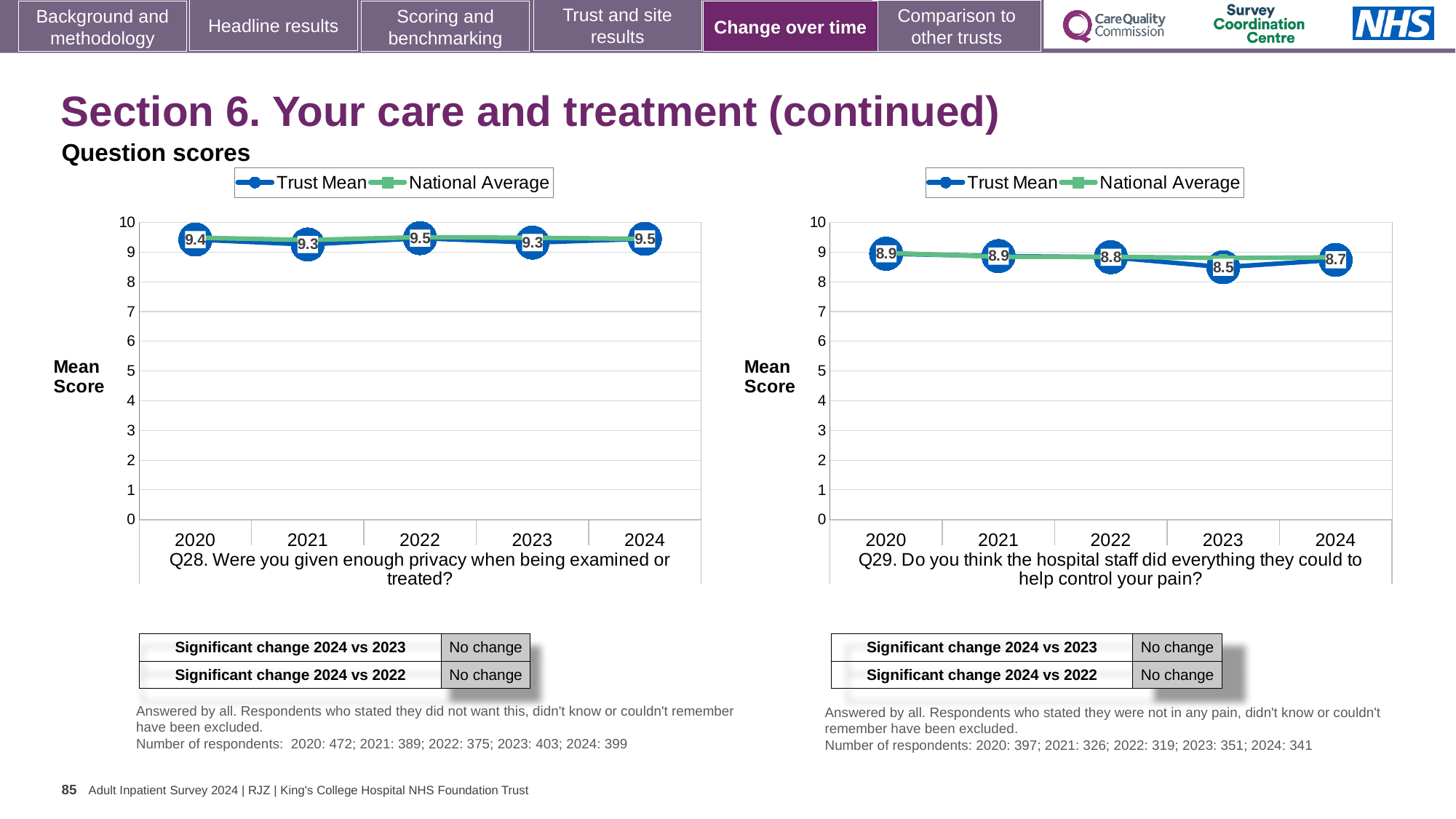
On the Q29 chart (right), what is the Trust Mean score for 2020? 8.9 On the Q29 chart (right), is the Trust Mean value for 2024 greater or less than 8? greater On the Q29 chart (right), what is the Trust Mean score for 2023? 8.5 What kind of chart is the Q28 chart (left)? Line chart On the Q29 chart (right), which year has the lowest Trust Mean score? 2023 On the Q28 chart (left), what is the difference between the Trust Mean scores for 2022 and 2023? 0.2 On the Q28 chart (left), what is the Trust Mean score for 2021? 9.3 How many years are shown on the x axis of the Q28 chart (left)? 5 On the Q28 chart (left), what is the Trust Mean score for 2024? 9.5 How many series does the legend of the Q29 chart (right) list? 2 On the Q29 chart (right), what is the difference between the Trust Mean scores for 2020 and 2023? 0.4 On the Q28 chart (left), is the Trust Mean score for 2020 larger or smaller than the score for 2022? smaller